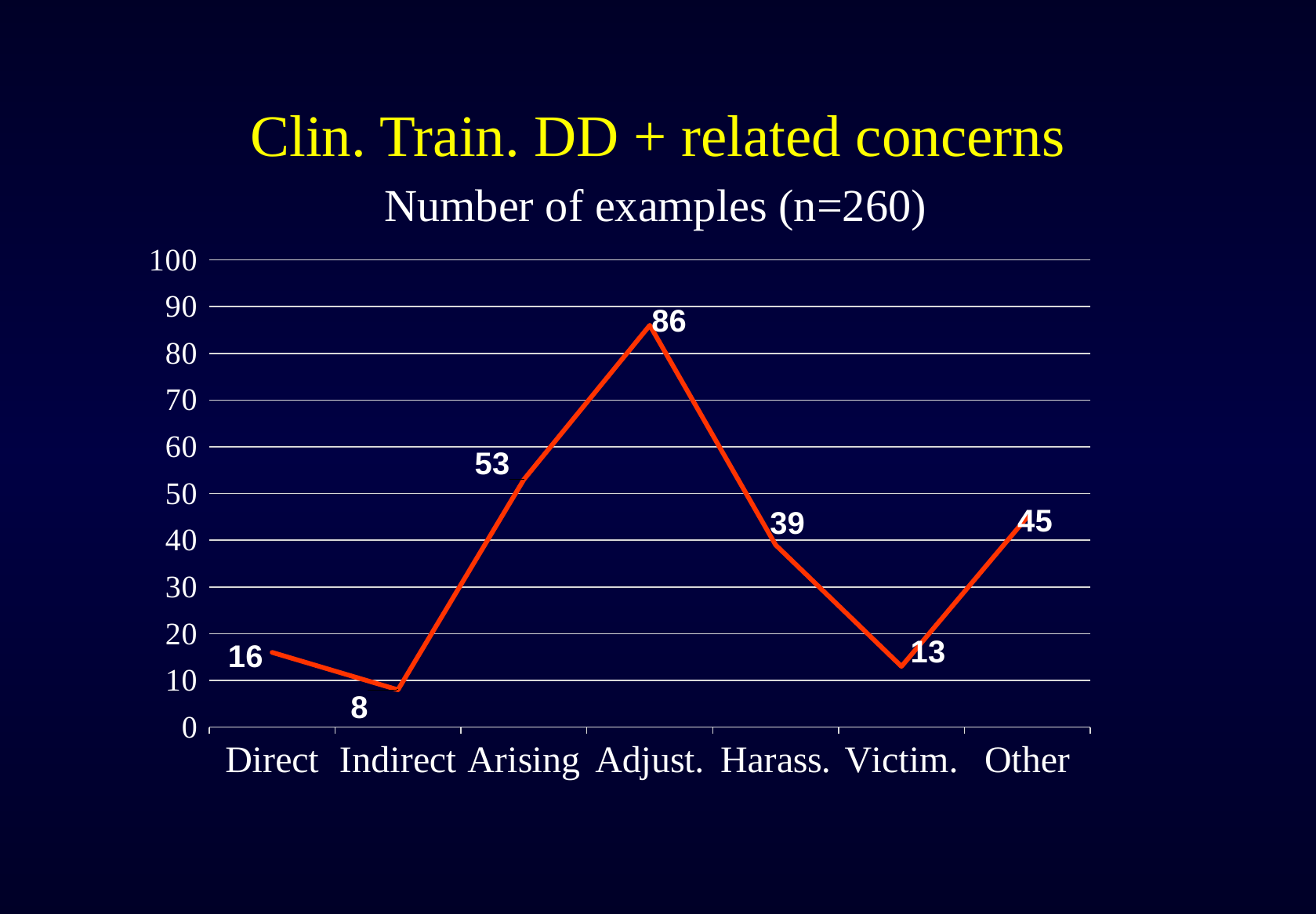
What is the difference between the values for Adjust. and Arising? 33 What is the value for Other? 45 Which is larger, the value for Harass. or the value for Other? Other What is the value for Adjust.? 86 What is the value for Indirect? 8 Does the value rise or fall from Direct to Indirect? fall Which category has the lowest value? Indirect Which category has the highest value? Adjust. What kind of chart is shown on the slide? line chart Is the value for Arising greater or less than 50? greater How many categories are shown on the x axis? 7